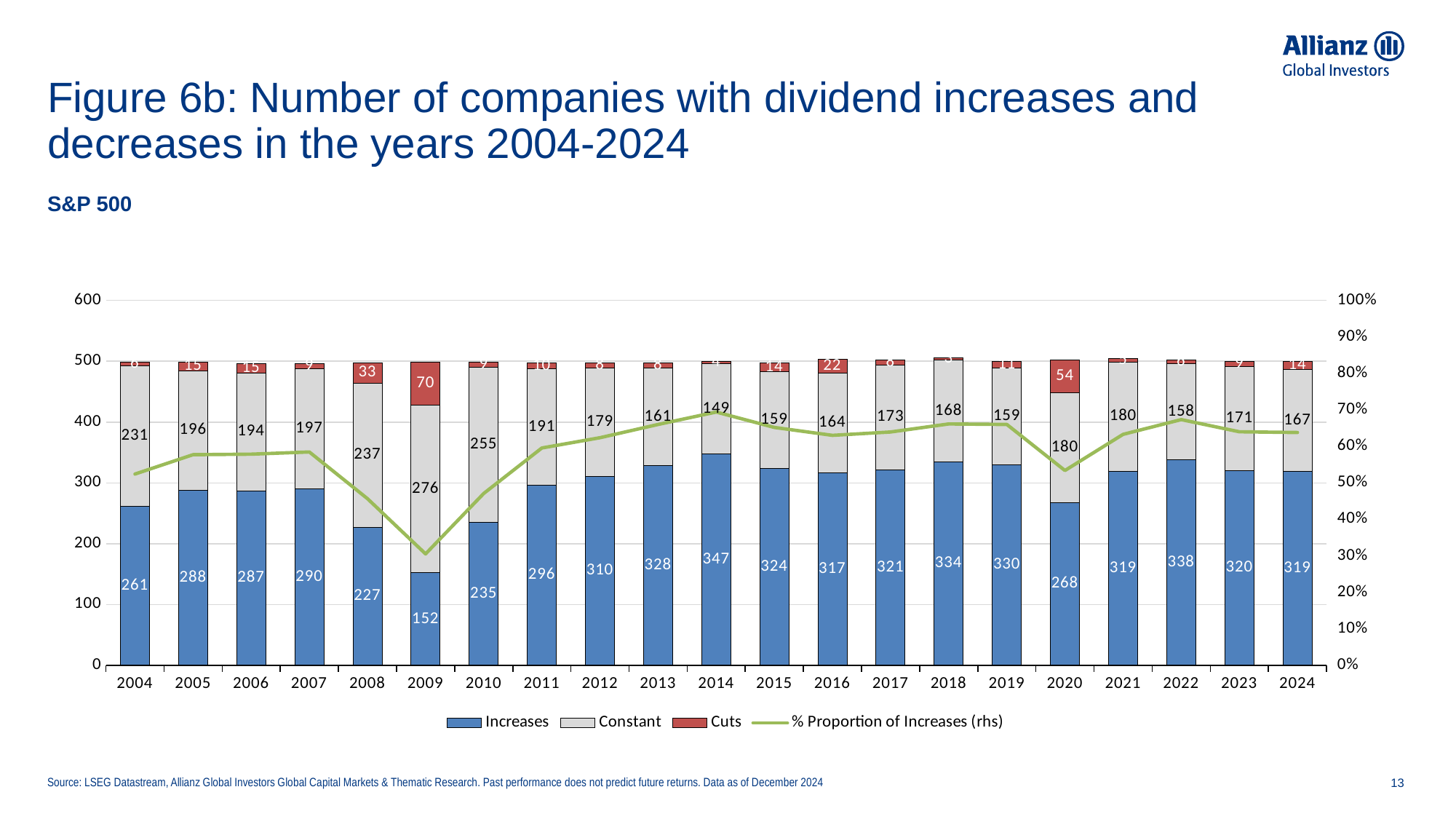
How many series does the legend list? 4 How many companies had dividend increases in 2014? 347 Is the % Proportion of Increases in 2009 greater or less than 40%? less In which year is the Cuts value the highest? 2009 What is the value of the Cuts series in 2009? 70 What is the total of the stacked bar for 2009 (Increases, Constant and Cuts)? 498 In which year is the Increases value the lowest? 2009 How many years are shown on the x axis? 21 What is the Constant value for 2020? 180 What is the difference between the Increases value in 2014 and in 2009? 195 Which year has a larger Cuts value, 2008 or 2020? 2020 In which year is the Increases value the highest? 2014